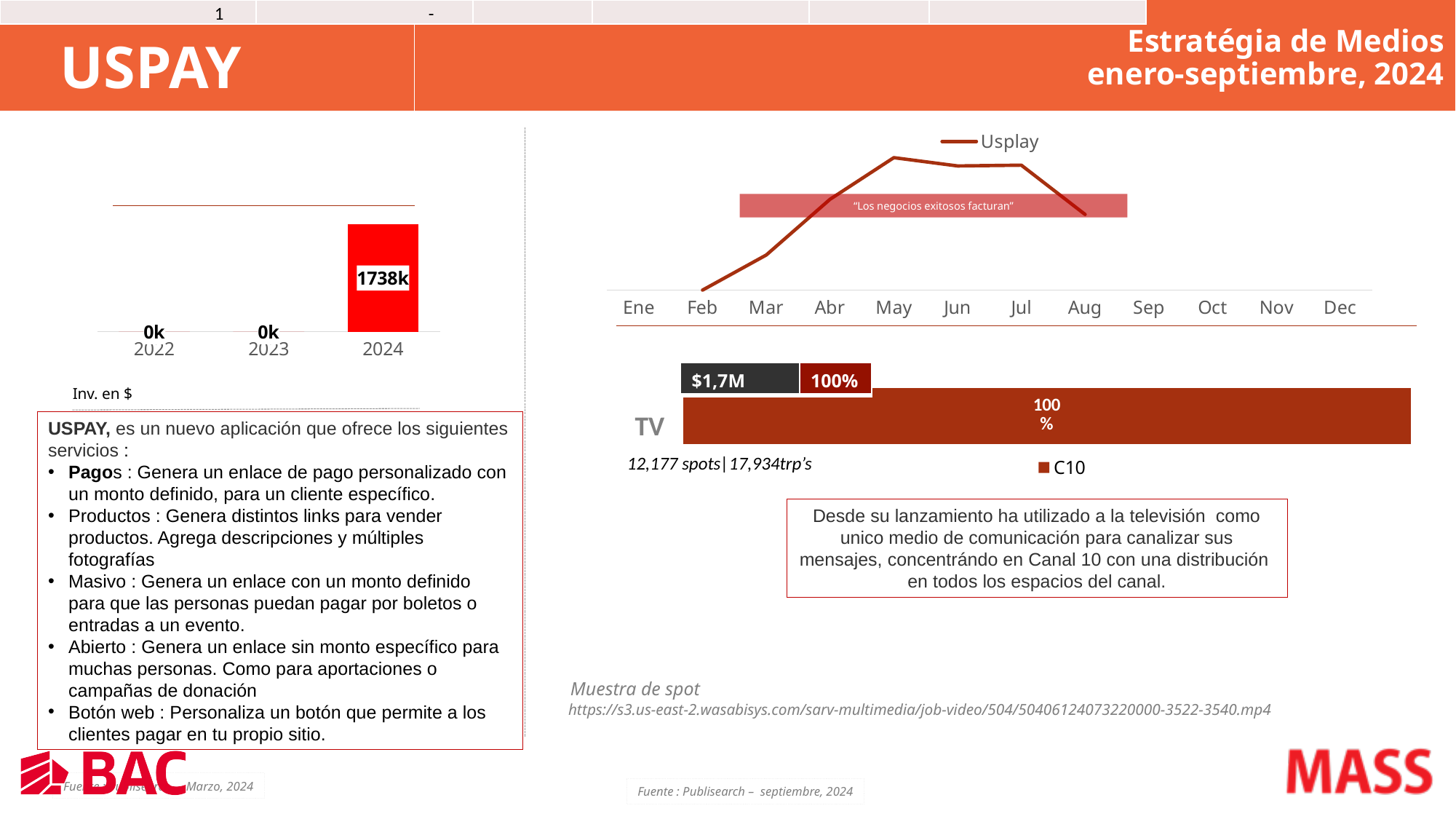
On the TV bar chart at the bottom right, how many series does the legend list? 1 On the line chart at the top right, how many months are labelled on the x axis? 12 On the TV bar chart at the bottom right, what percentage is shown for C10? 100% What kind of chart is the chart on the left showing investment by year? bar chart On the bar chart on the left (Inv. en $), which year has the highest value? 2024 On the line chart at the top right, what series name does the legend show? Usplay On the bar chart on the left (Inv. en $), what is the value for 2024? 1738k On the bar chart on the left (Inv. en $), what is the difference between the 2024 value and the 2023 value? 1738k On the line chart at the top right, does the Usplay line rise or fall between Feb and May? rise On the bar chart on the left (Inv. en $), what is the value for 2022? 0k On the bar chart on the left (Inv. en $), how many years are shown on the x axis? 3 On the line chart at the top right, in which month does the Usplay line reach its highest point? May